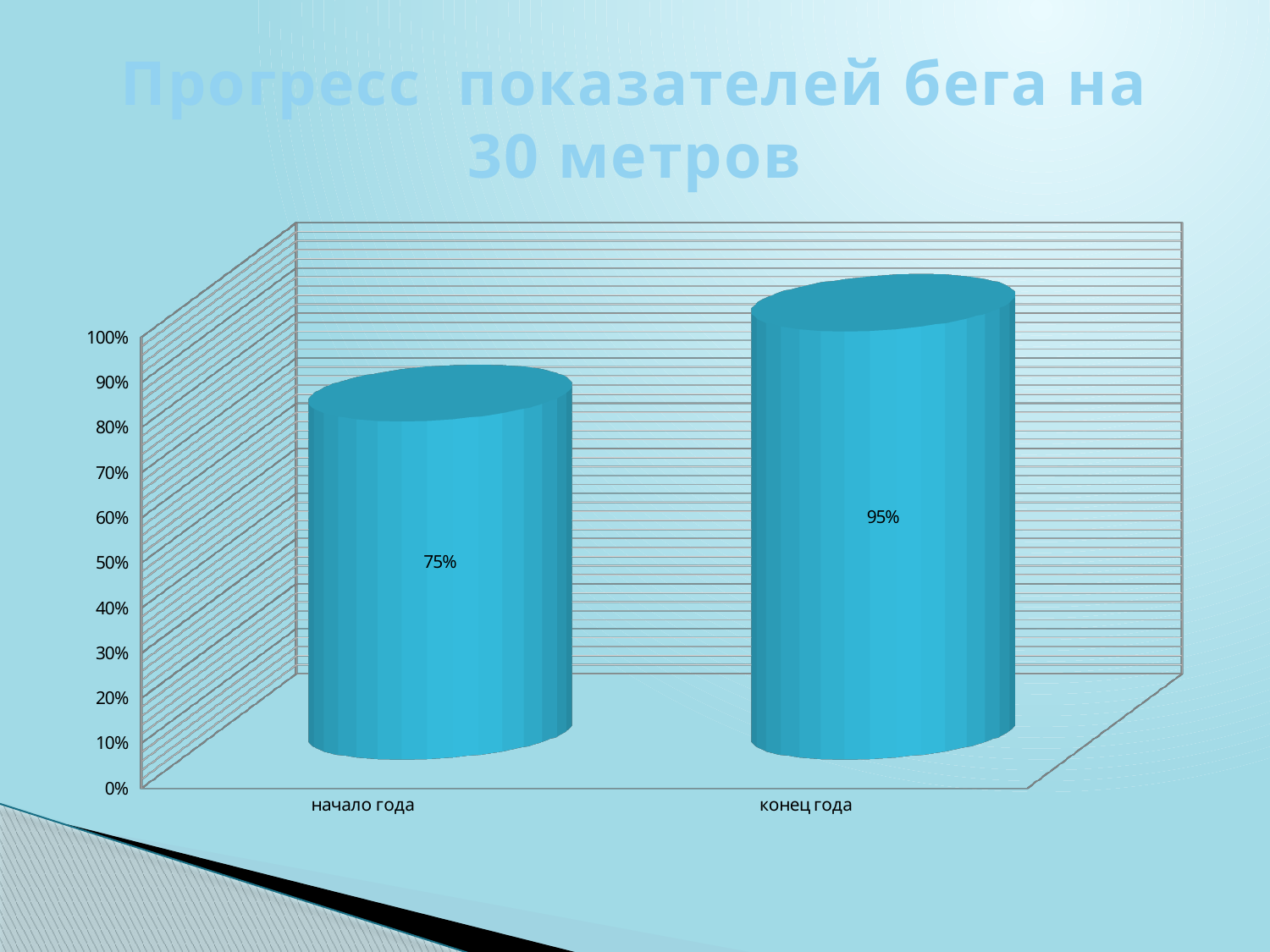
What is the title of the chart? Прогресс показателей бега на 30 метров What kind of chart is shown on the slide? bar chart Which category has the lowest value? начало года What is the value for начало года? 75% Is the value for начало года greater or less than 80%? less Is the value for конец года greater or less than 90%? greater Do the values rise or fall from начало года to конец года? rise How many categories are shown on the x axis? 2 What is the difference between the values for конец года and начало года? 20% What is the value for конец года? 95% Which is larger, the value for начало года or the value for конец года? конец года Which category has the highest value? конец года